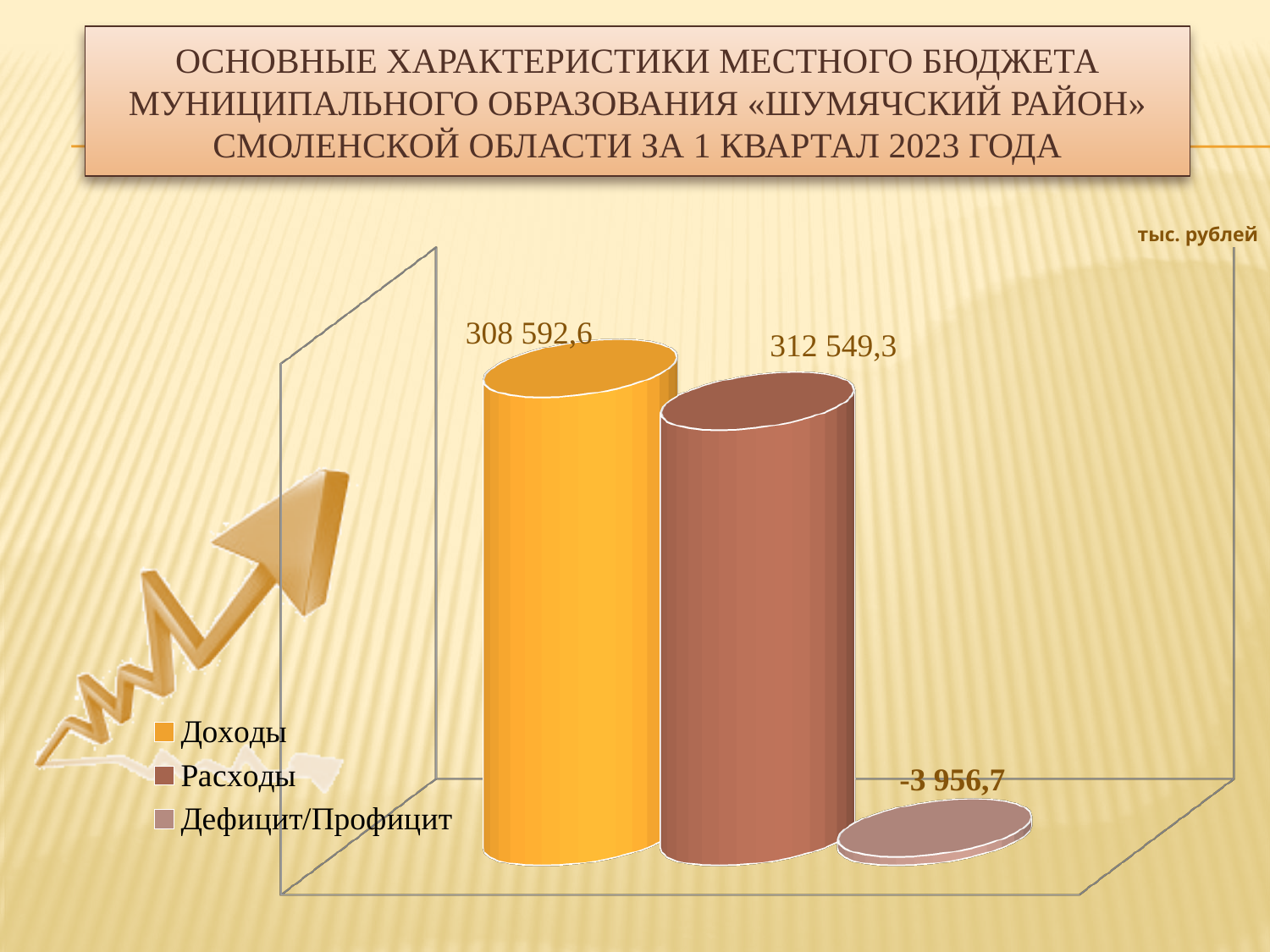
Which is larger, Доходы or Расходы? Расходы Which series has the highest value? Расходы What is the difference between Расходы and Доходы? 3 956,7 In what units are the chart values given? тыс. рублей How many bars are plotted on the chart? 3 What kind of chart is shown on the slide? Bar chart What is the value for Расходы? 312 549,3 What colour is the bar for Доходы? Orange/yellow How many series does the legend list? 3 Which series has the lowest value? Дефицит/Профицит What is the value for Дефицит/Профицит? -3 956,7 What is the value for Доходы? 308 592,6